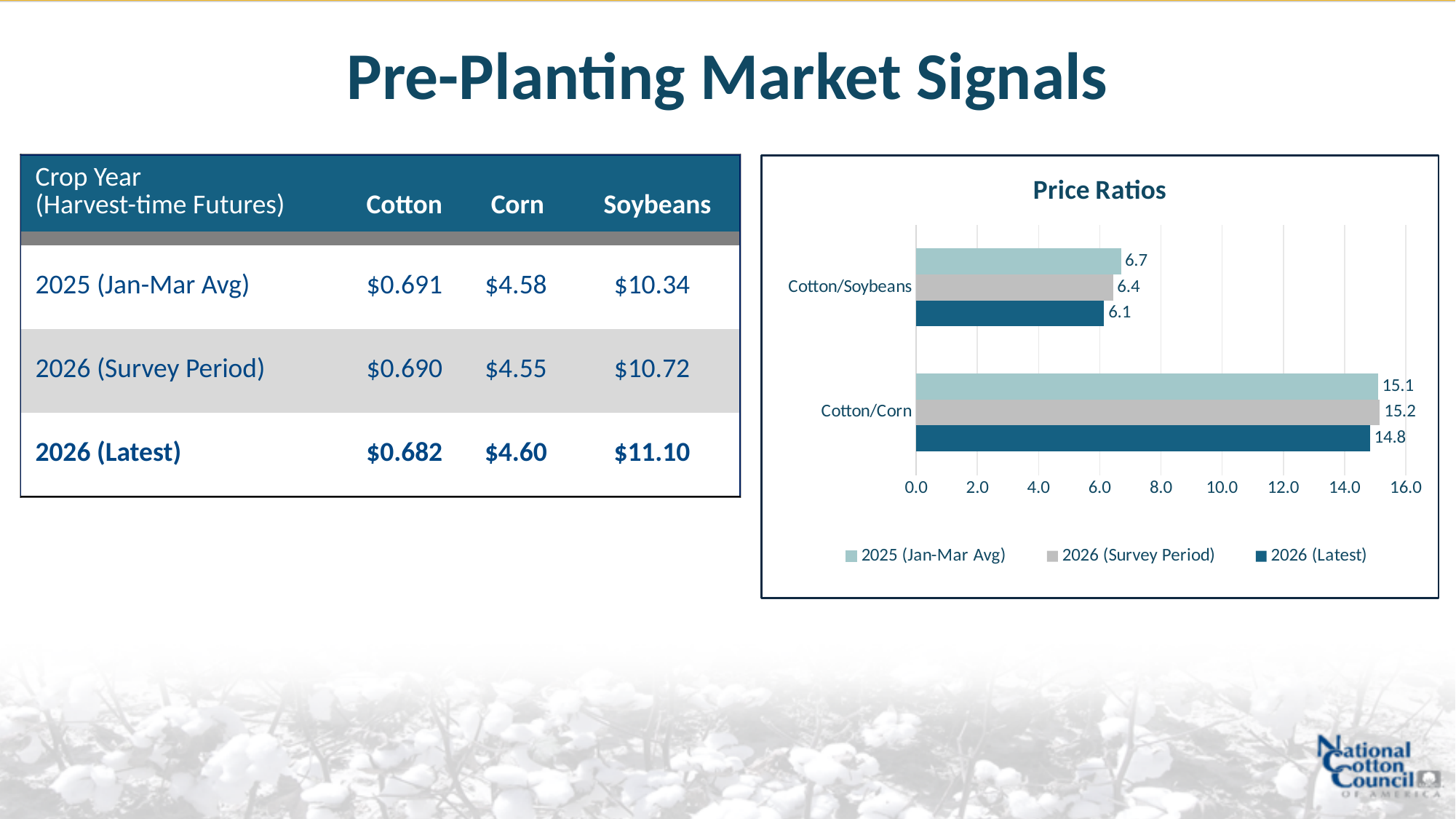
What kind of chart is the Price Ratios chart? bar chart Which series has the highest Cotton/Corn price ratio? 2026 (Survey Period) What is the Cotton/Corn price ratio for 2026 (Latest)? 14.8 Which is larger: the Cotton/Soybeans ratio for 2025 (Jan-Mar Avg) or for 2026 (Survey Period)? 2025 (Jan-Mar Avg) What is the difference between the Cotton/Corn ratio for 2026 (Survey Period) and 2026 (Latest)? 0.4 Which series has the lowest Cotton/Soybeans price ratio? 2026 (Latest) How many series does the legend of the Price Ratios chart list? 3 What is the Cotton/Soybeans price ratio for 2026 (Latest)? 6.1 How many categories are shown on the Price Ratios chart? 2 What is the Cotton/Corn price ratio for 2026 (Survey Period)? 15.2 What is the Cotton/Soybeans price ratio for 2025 (Jan-Mar Avg)? 6.7 Is the Cotton/Corn ratio for 2026 (Latest) greater or less than 14.0? greater